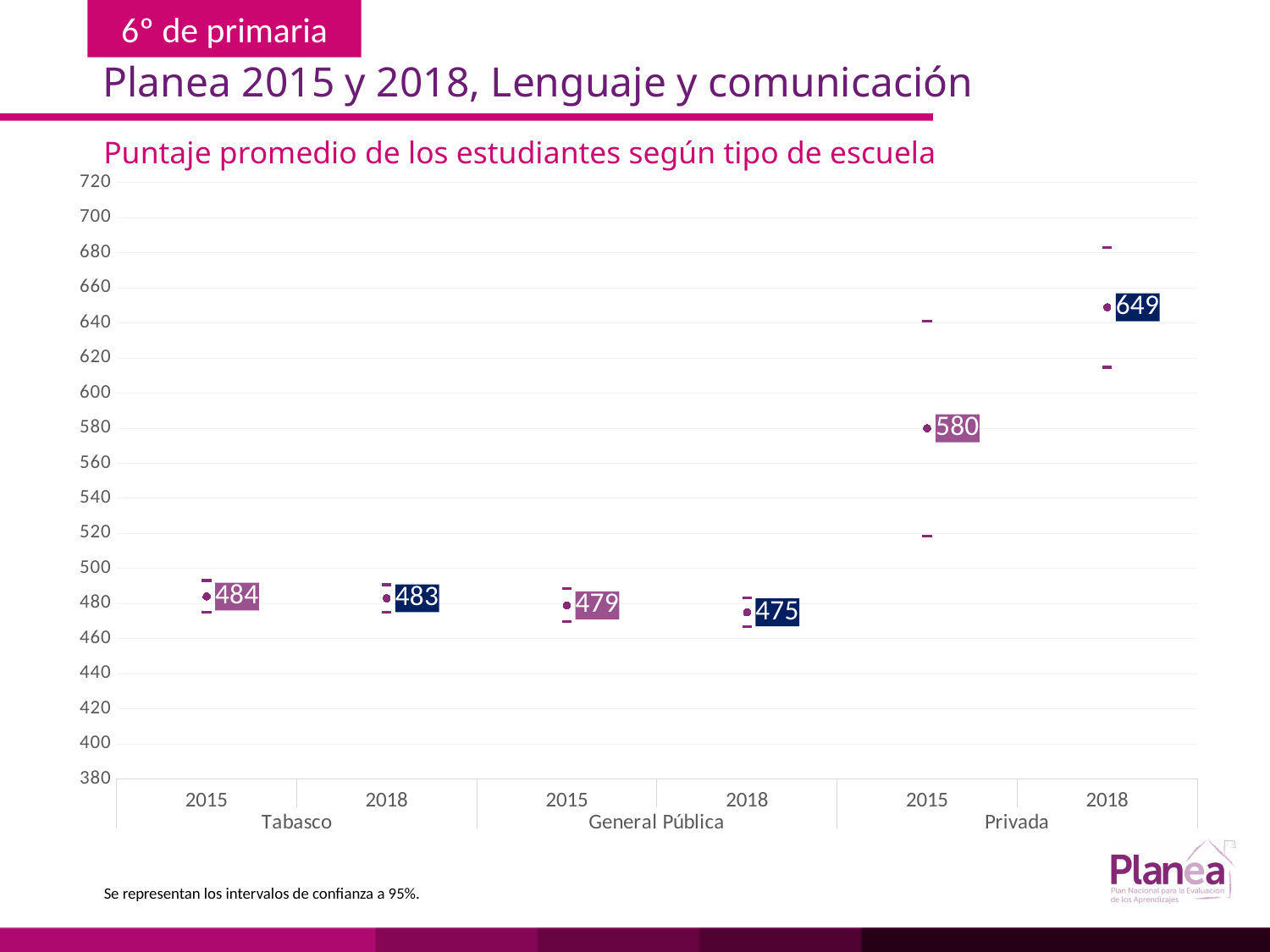
What is the average score for Tabasco in 2015? 484 What is the average score for Privada schools in 2015? 580 Which is larger, the Tabasco 2018 score or the General Pública 2018 score? Tabasco 2018 What is the title of the chart? Puntaje promedio de los estudiantes según tipo de escuela Did the Privada average score rise or fall from 2015 to 2018? rise What is the difference between the General Pública scores in 2015 and 2018? 4 What is the average score for Privada schools in 2018? 649 Which group and year has the lowest average score? General Pública 2018 What is the difference between the Privada scores in 2018 and 2015? 69 What is the average score for General Pública in 2018? 475 Which group and year has the highest average score? Privada 2018